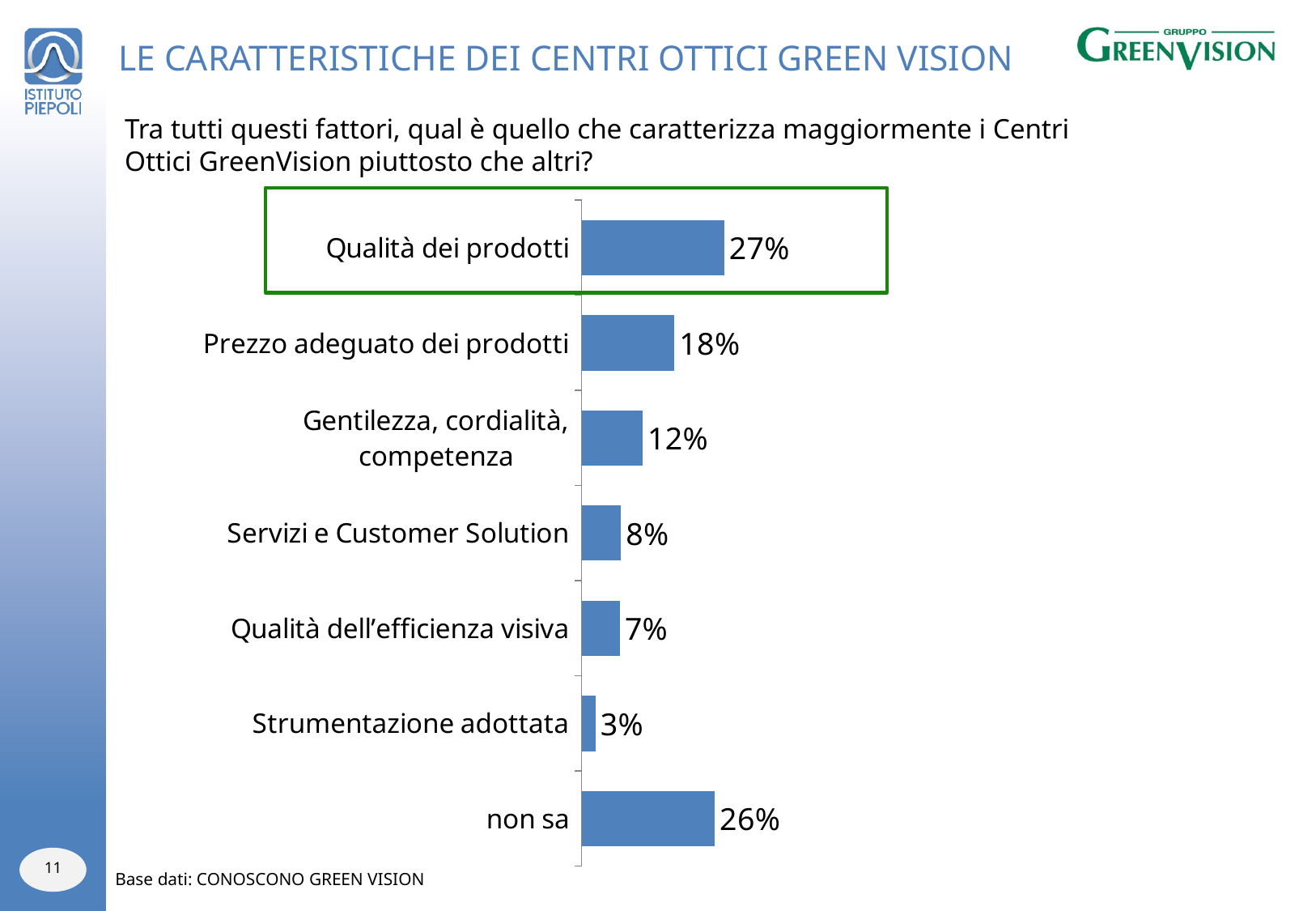
What value is shown for "non sa"? 26% What kind of chart is shown on the slide? Bar chart What percentage is shown for "Strumentazione adottata"? 3% Which category has the lowest value? Strumentazione adottata Which is larger: "Gentilezza, cordialità, competenza" or "Servizi e Customer Solution"? Gentilezza, cordialità, competenza What value is shown for "Prezzo adeguato dei prodotti"? 18% What is the difference between "Qualità dei prodotti" and "Prezzo adeguato dei prodotti"? 9% What is the difference between "Servizi e Customer Solution" and "Qualità dell'efficienza visiva"? 1% Which category is highlighted with a green box on the slide? Qualità dei prodotti How many categories are shown in the chart? 7 Which category has the highest value? Qualità dei prodotti What percentage is shown for "Qualità dei prodotti"? 27%